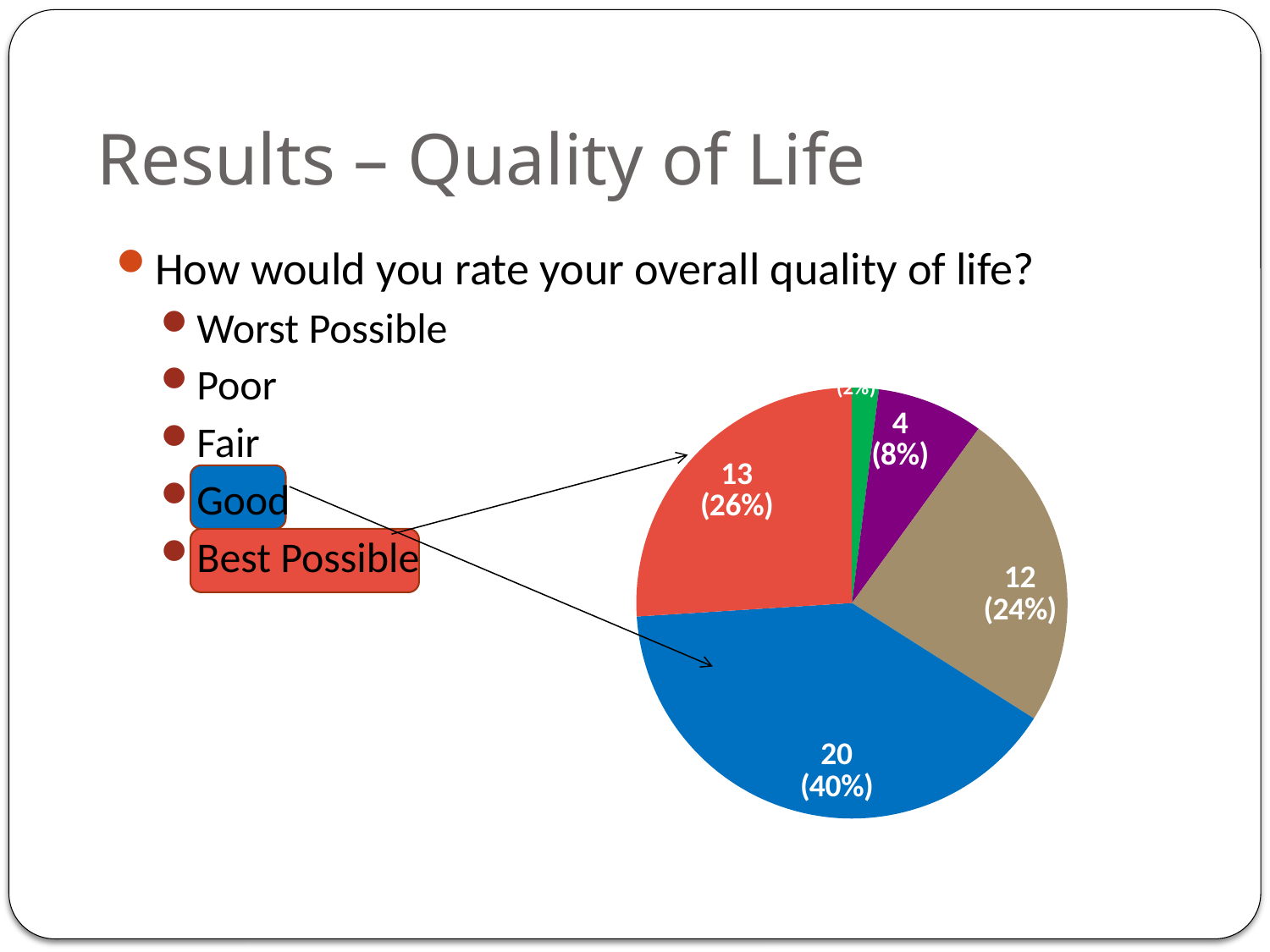
How many slices does the pie chart have? 5 Which is larger, the Good slice or the Best Possible slice? Good Which rating has the largest slice in the pie chart? Good What share of the pie does the Best Possible slice represent? 26% What count is shown on the purple slice of the pie chart? 4 What percentage of the pie chart corresponds to the Good rating? 40% What kind of chart is shown on the slide? Pie chart What percentage is shown on the tan slice of the pie chart? 24% How many respondents rated their quality of life as Good, according to the pie chart? 20 Which slice of the pie chart is the smallest? The green slice (2%) What is the difference in respondent count between the Good slice and the Best Possible slice? 7 How many respondents rated their quality of life as Best Possible? 13